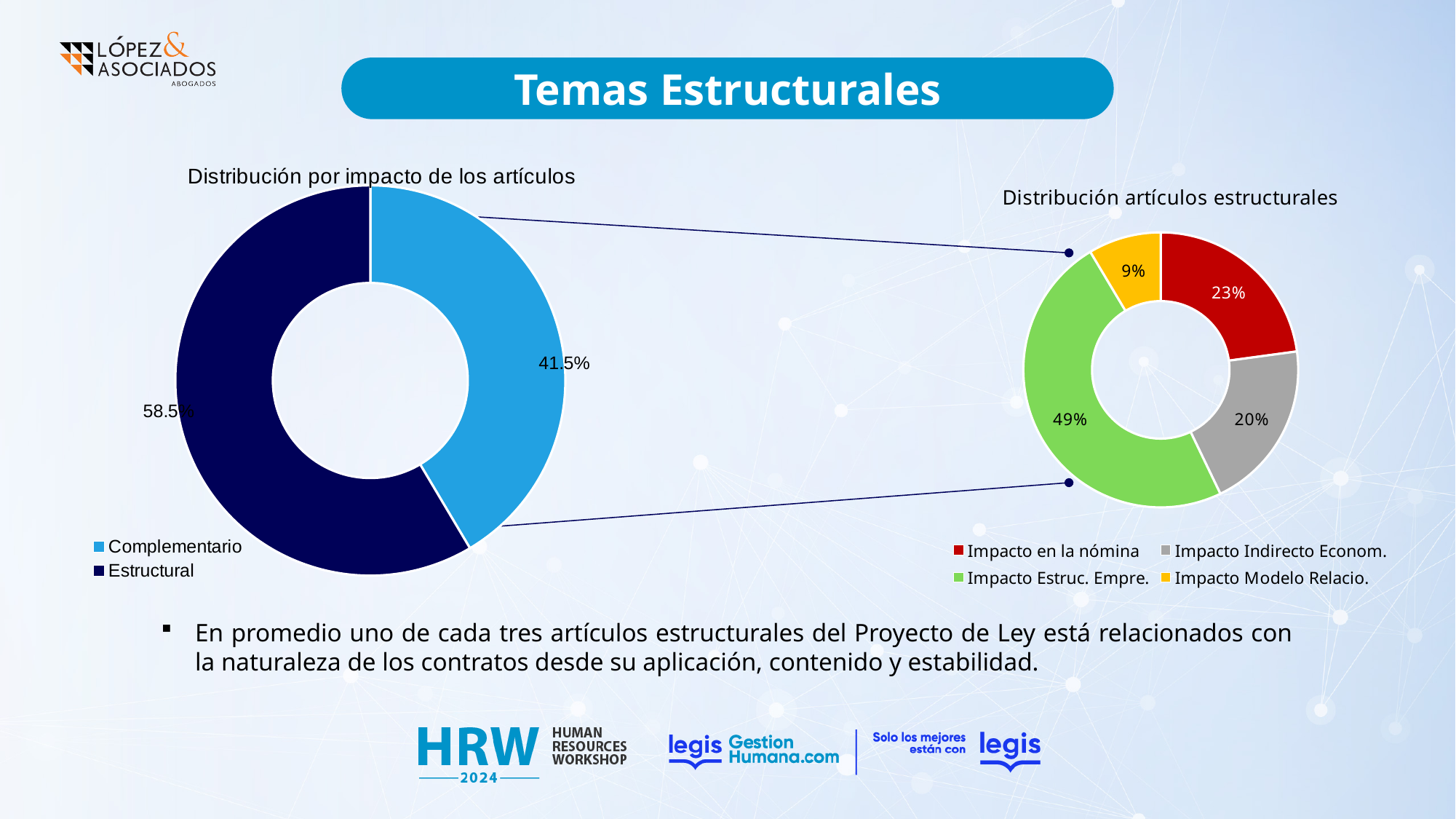
In the chart titled "Distribución artículos estructurales", what is the value for Impacto Estruc. Empre.? 49% What kind of chart is "Distribución por impacto de los artículos"? Doughnut chart In the chart titled "Distribución artículos estructurales", which category has the largest share? Impacto Estruc. Empre. In the chart titled "Distribución artículos estructurales", which category has the smallest share? Impacto Modelo Relacio. In the chart titled "Distribución por impacto de los artículos", what is the value for Complementario? 41.5% In the chart titled "Distribución por impacto de los artículos", what is the difference between Estructural and Complementario? 17% In the chart titled "Distribución por impacto de los artículos", which category has the larger share? Estructural In the chart titled "Distribución por impacto de los artículos", what is the value for Estructural? 58.5% How many categories does the legend of "Distribución artículos estructurales" list? 4 In the chart titled "Distribución artículos estructurales", what is the value for Impacto en la nómina? 23% In the chart titled "Distribución artículos estructurales", what colour is the Impacto Modelo Relacio. slice? Yellow In the chart titled "Distribución artículos estructurales", which is larger: Impacto en la nómina or Impacto Indirecto Econom.? Impacto en la nómina